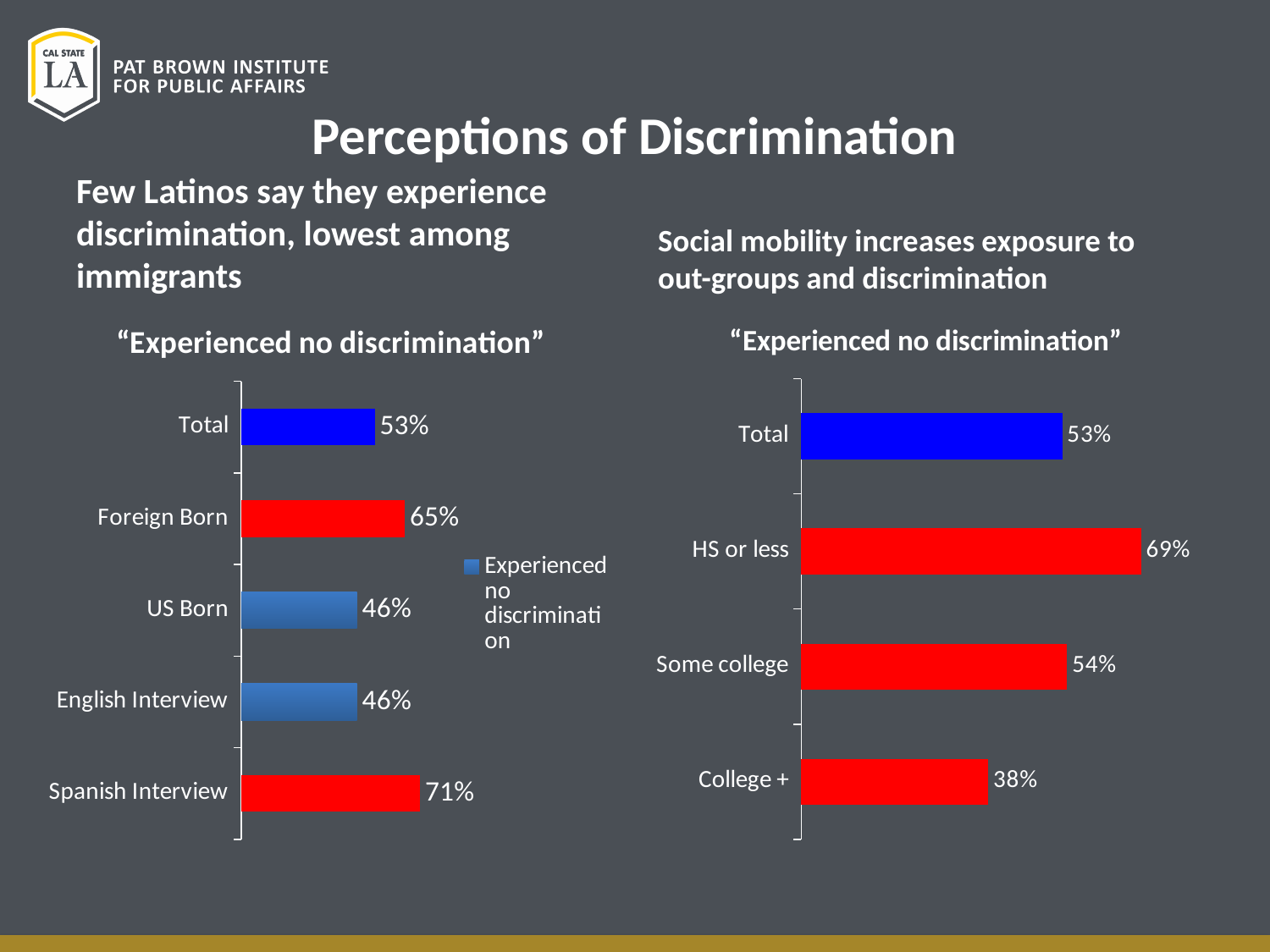
In the left chart, which category has the highest value? Spanish Interview In the right chart, what is the difference between HS or less and College +? 31% In the left chart, what is the value for Spanish Interview? 71% In the left chart, what series does the legend list? Experienced no discrimination In the right chart, which is larger, Some college or College +? Some college What type of chart is the right chart? Bar chart In the right chart, what is the value for HS or less? 69% In the left chart, what is the value for Foreign Born? 65% In the left chart, what is the difference between Foreign Born and US Born? 19% In the left chart, how many categories are shown? 5 In the right chart, which category has the lowest value? College + In the right chart, what is the value for College +? 38%